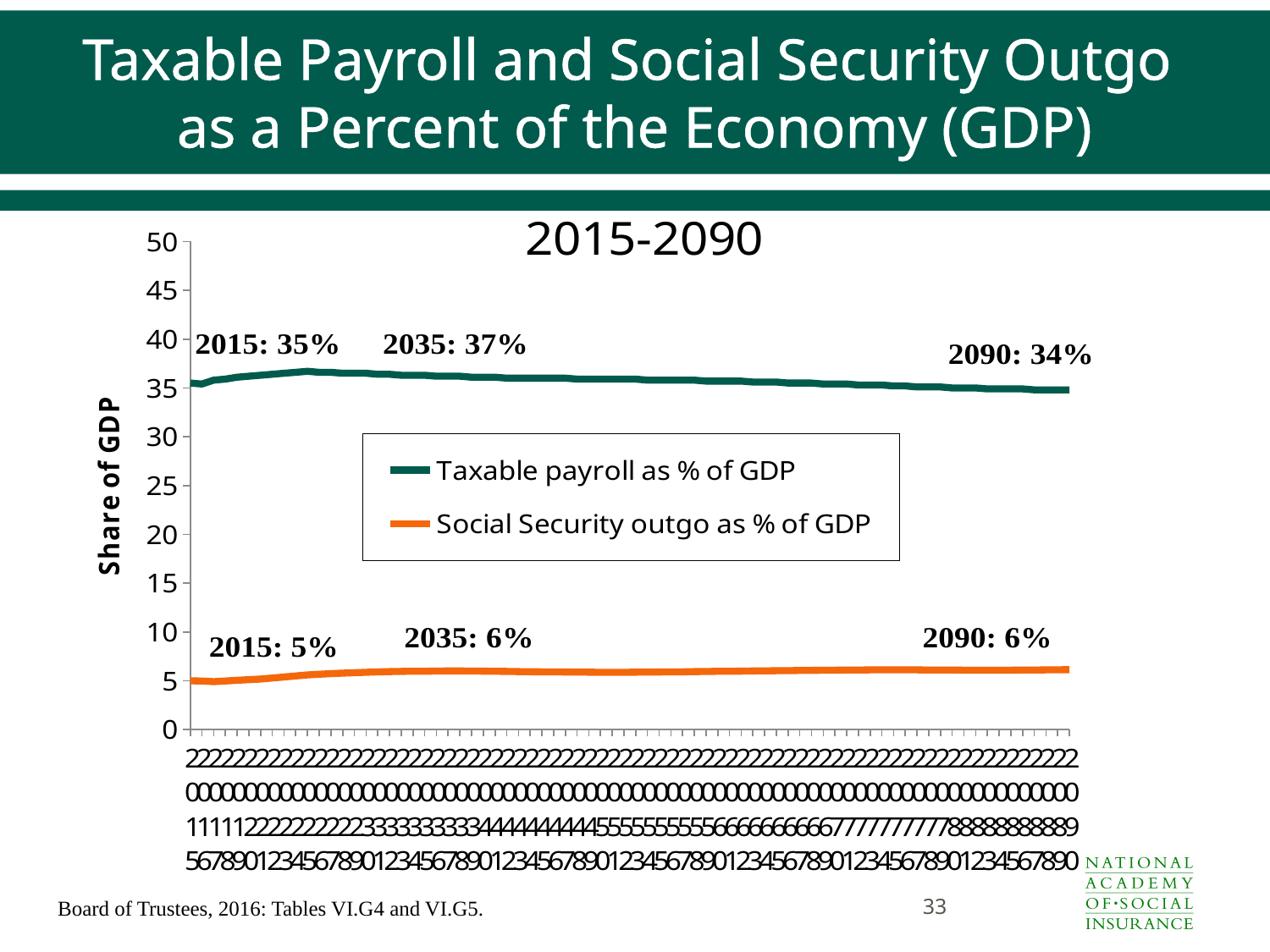
Does taxable payroll as % of GDP rise or fall between 2035 and 2090? Fall What is taxable payroll as a percent of GDP in 2035? 37% What is the label on the vertical axis? Share of GDP Is the value for Social Security outgo as % of GDP in 2090 greater or less than 10? less How many series does the legend list? 2 What is Social Security outgo as a percent of GDP in 2090? 6% What is the difference between taxable payroll and Social Security outgo as a percent of GDP in 2035? 31% What kind of chart is shown on the slide? Line chart What is taxable payroll as a percent of GDP in 2090? 34% What is Social Security outgo as a percent of GDP in 2015? 5% Which series is higher throughout the chart, taxable payroll or Social Security outgo? Taxable payroll as % of GDP What is taxable payroll as a percent of GDP in 2015? 35%